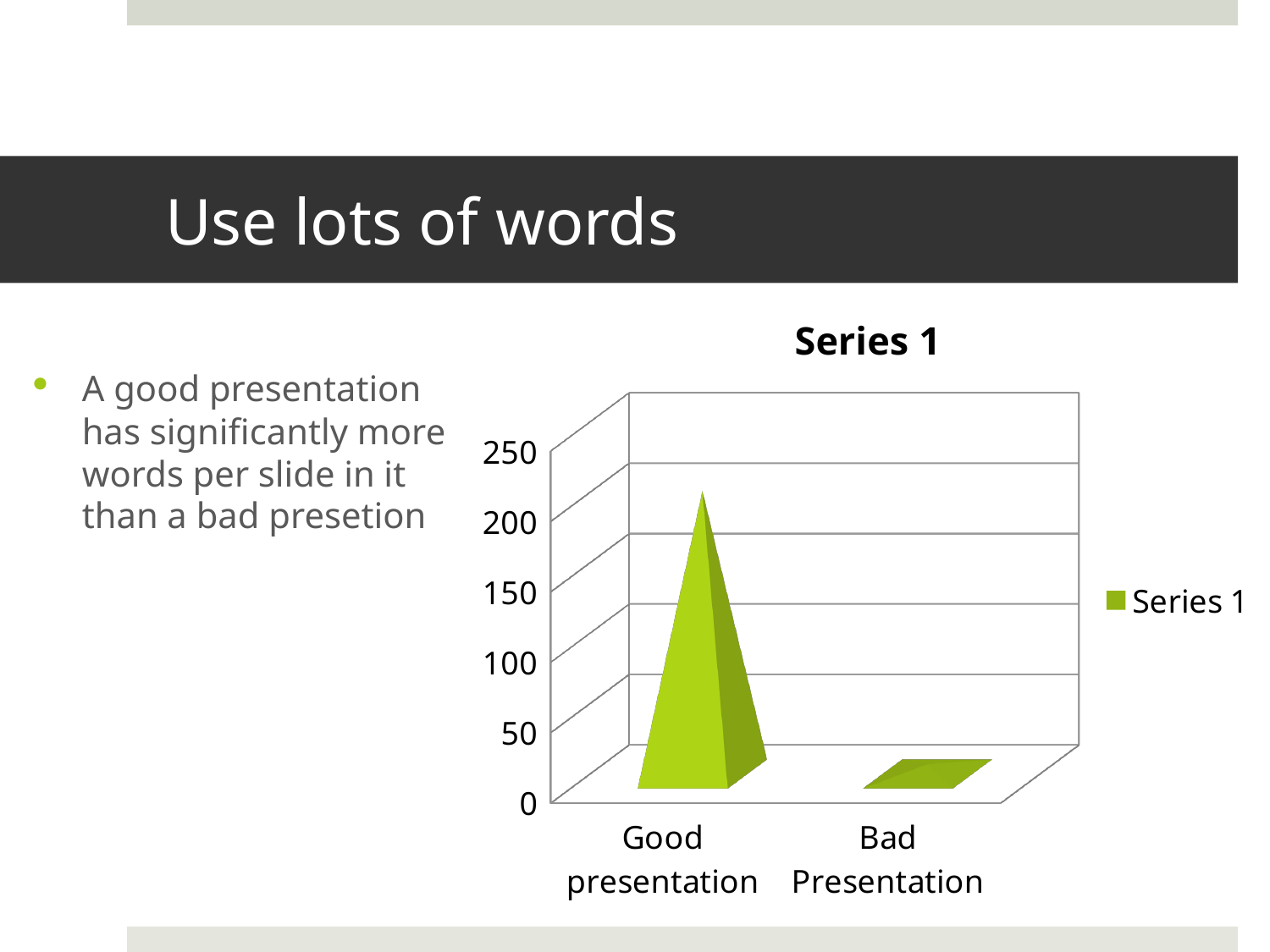
What is the highest value shown on the vertical axis of the chart? 250 Which category has the lowest value in the chart? Bad Presentation How many series does the chart legend list? 1 What kind of chart is shown on the slide? bar chart Which category has the highest value in the chart? Good presentation Which is larger, the value for Good presentation or the value for Bad Presentation? Good presentation Is the value for Bad Presentation greater or less than 50? less Is the value for Good presentation greater or less than 100? greater Do the values rise or fall from left to right along the x axis? fall What is the title of the chart? Series 1 Is the value for Good presentation greater or less than 150? greater How many categories are shown on the x axis of the chart? 2